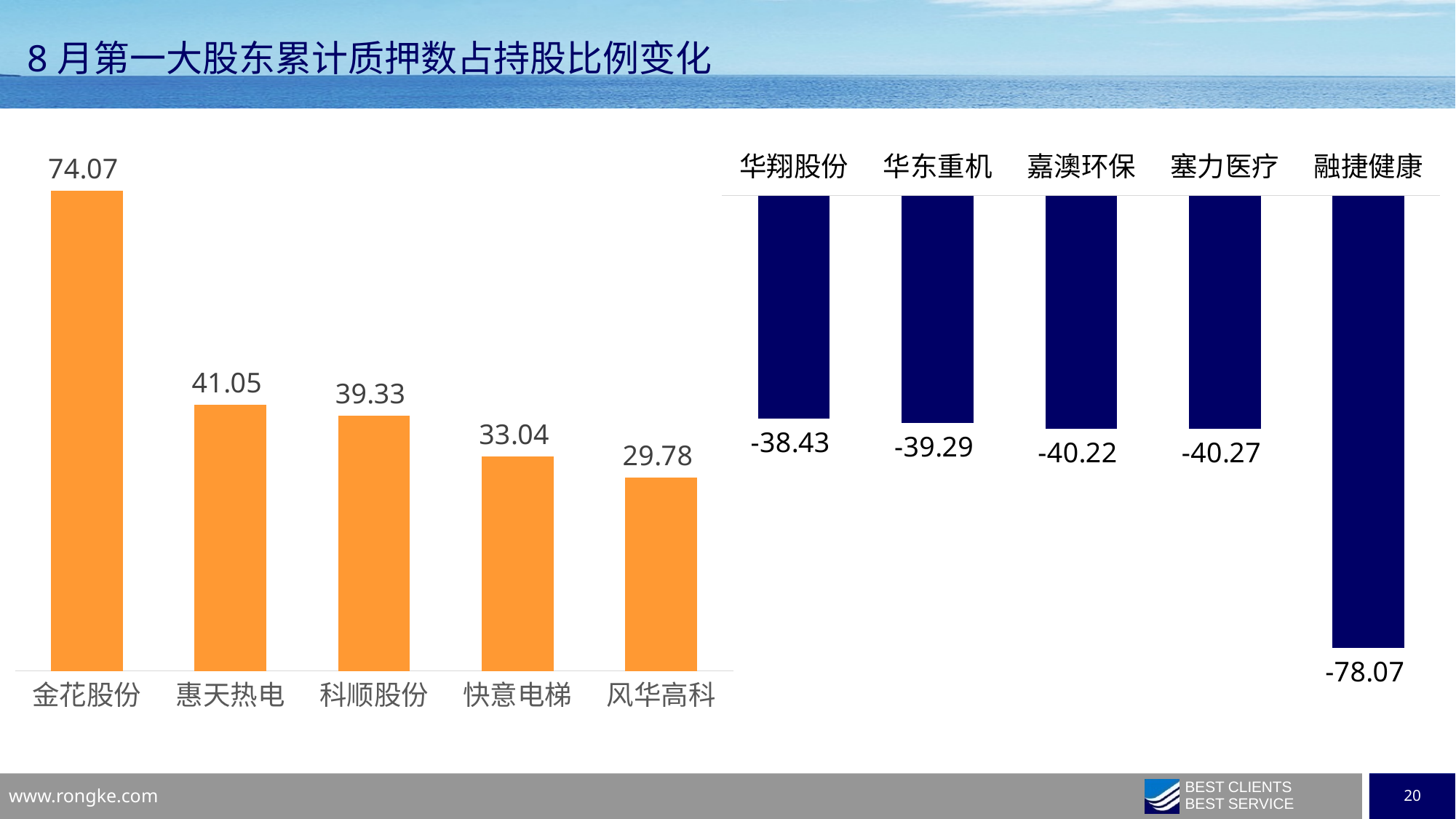
How many categories are shown in the right chart? 5 In the left chart, what is the difference between the values for 金花股份 and 惠天热电? 33.02 In the left chart, which category has the highest value? 金花股份 In the left chart, which category has the lowest value? 风华高科 In the right chart, what is the value for 融捷健康? -78.07 In the right chart, what is the value for 嘉澳环保? -40.22 In the left chart, what is the value for 金花股份? 74.07 In the right chart, what is the difference between the values for 华翔股份 and 融捷健康? 39.64 In the right chart, which category has the lowest value? 融捷健康 In the left chart, what is the value for 快意电梯? 33.04 In the left chart, which is larger, the value for 科顺股份 or the value for 快意电梯? 科顺股份 What kind of chart is the left chart? Bar chart